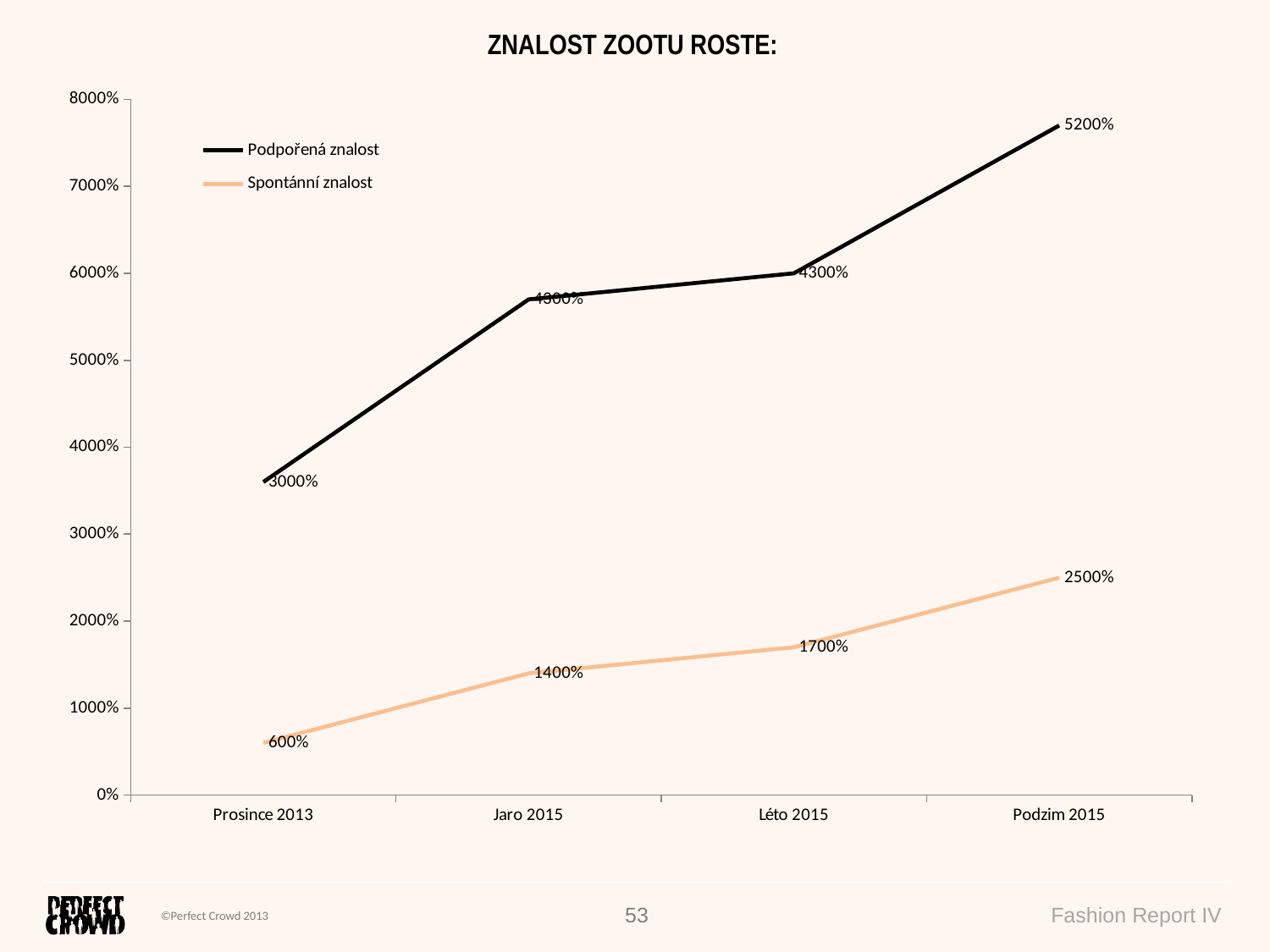
What is the value of Podpořená znalost for Podzim 2015? 5200% What is the value of Spontánní znalost for Léto 2015? 1700% What is the value of Spontánní znalost for Prosince 2013? 600% How many series does the legend list? 2 In which period is Spontánní znalost highest? Podzim 2015 Does Spontánní znalost rise or fall from Prosince 2013 to Podzim 2015? Rise What kind of chart is shown on the slide? Line chart How many time periods are shown on the x axis? 4 What is the difference between Podpořená znalost and Spontánní znalost in Podzim 2015? 2700% What is the value of Podpořená znalost for Léto 2015? 4300% Which is larger in Léto 2015: Podpořená znalost or Spontánní znalost? Podpořená znalost In which period is Podpořená znalost lowest? Prosince 2013